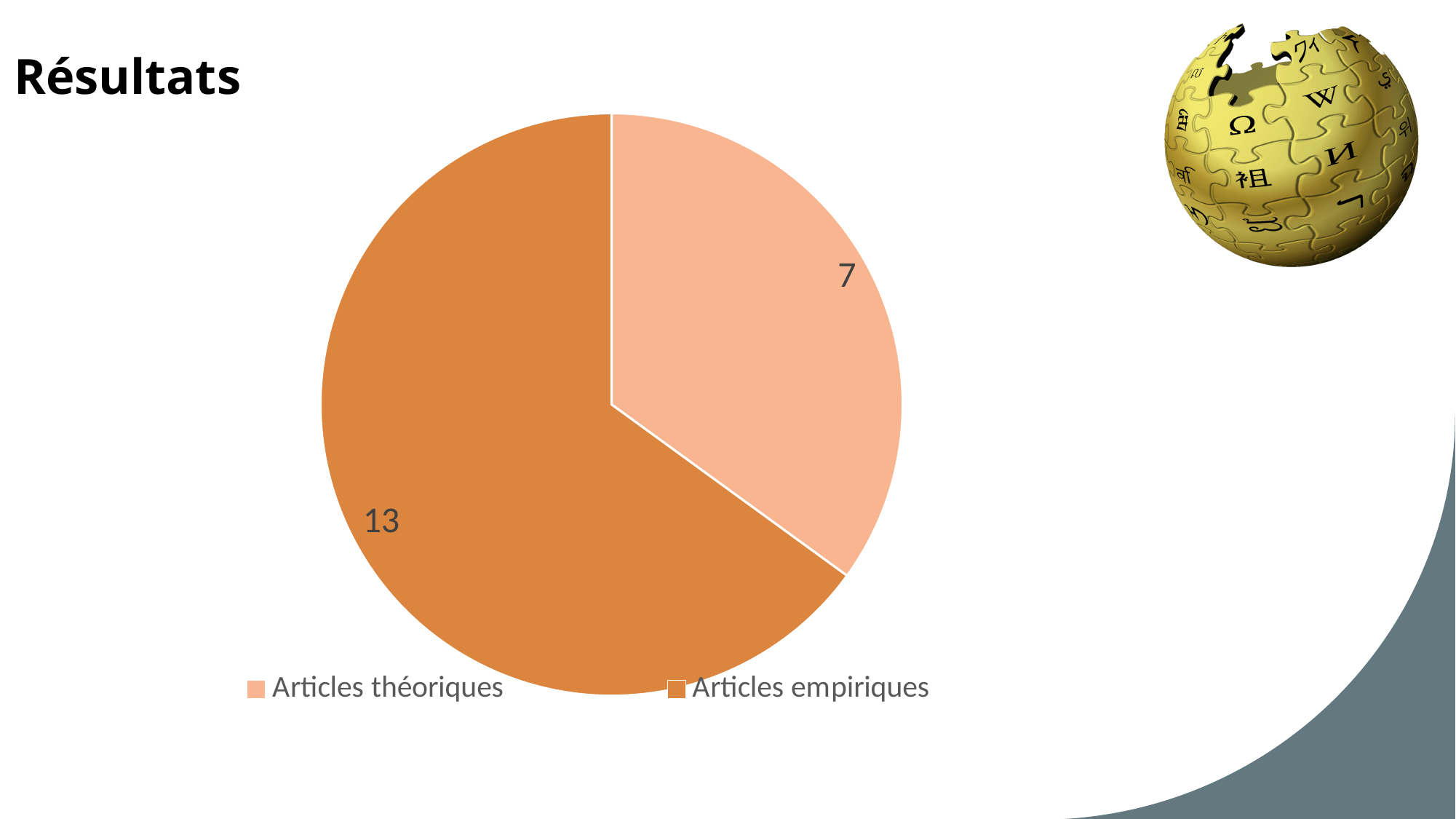
Which category has the smallest slice? Articles théoriques What kind of chart is shown on the slide? pie chart What is the title of the slide containing the chart? Résultats What is the difference between the values for Articles empiriques and Articles théoriques? 6 What is the total of the two slices? 20 Which category has the largest slice? Articles empiriques What share of the pie does Articles théoriques represent? 35% What is the value for Articles empiriques? 13 Which is larger, Articles théoriques or Articles empiriques? Articles empiriques How many slices does the pie chart have? 2 What is the value for Articles théoriques? 7 What share of the pie does Articles empiriques represent? 65%